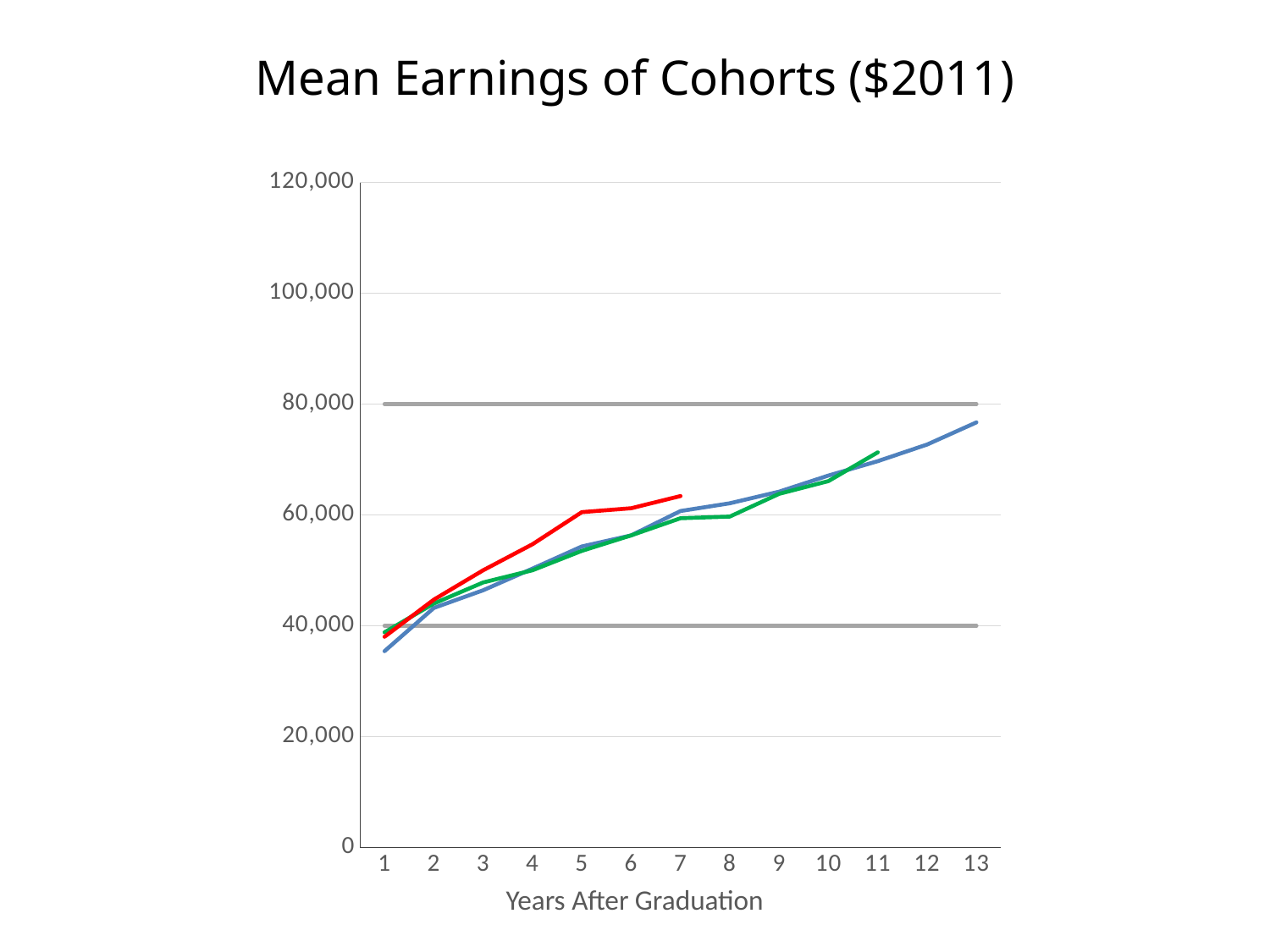
Is the value of the blue line at year 1 greater or less than 40,000? less Is the value of the blue line at year 13 greater or less than 80,000? less How many years after graduation are marked along the x axis? 13 Does the blue line rise or fall as years after graduation increase? Rises Is the value of the red line at year 7 greater or less than 60,000? greater Which coloured line extends to year 13 on the x axis? Blue line What is the label on the x axis of the chart? Years After Graduation At what values are the two grey horizontal reference lines drawn? 80,000 and 40,000 What is the title of the chart? Mean Earnings of Cohorts ($2011) At year 5, which line has the higher value, the red line or the blue line? Red line What kind of chart is shown on the slide? Line chart